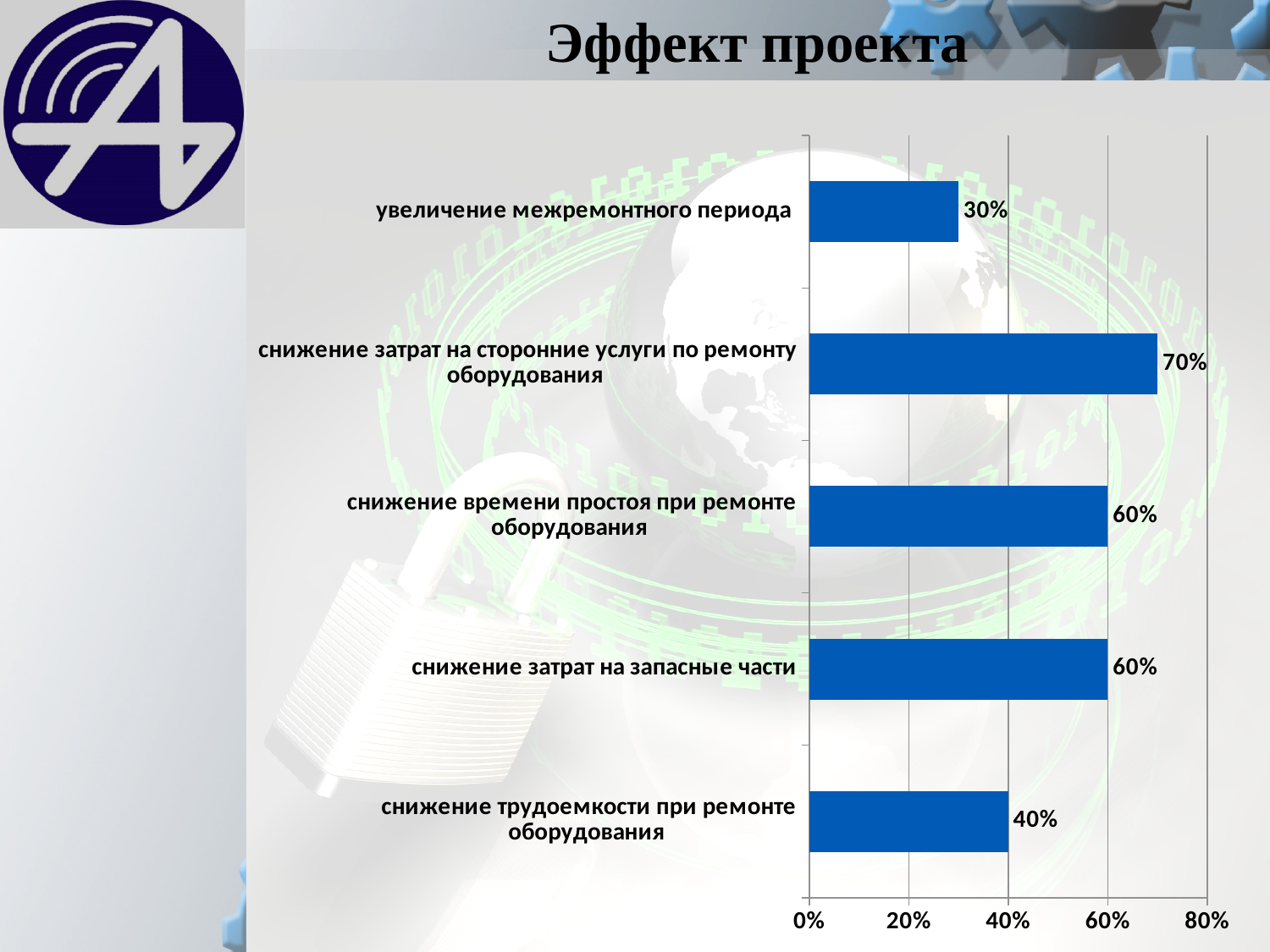
What is the maximum value shown on the horizontal axis? 80% Which category has the lowest value? увеличение межремонтного периода What kind of chart is shown on the slide? bar chart What is the value for 'увеличение межремонтного периода'? 30% What is the value for 'снижение затрат на запасные части'? 60% How many categories are shown in the chart? 5 What is the value for 'снижение затрат на сторонние услуги по ремонту оборудования'? 70% What is the title of the slide? Эффект проекта Which is larger: the value for 'снижение трудоемкости при ремонте оборудования' or the value for 'снижение времени простоя при ремонте оборудования'? снижение времени простоя при ремонте оборудования What is the value for 'снижение трудоемкости при ремонте оборудования'? 40% What is the difference between the values for 'снижение затрат на сторонние услуги по ремонту оборудования' and 'увеличение межремонтного периода'? 40% Which category has the highest value? снижение затрат на сторонние услуги по ремонту оборудования